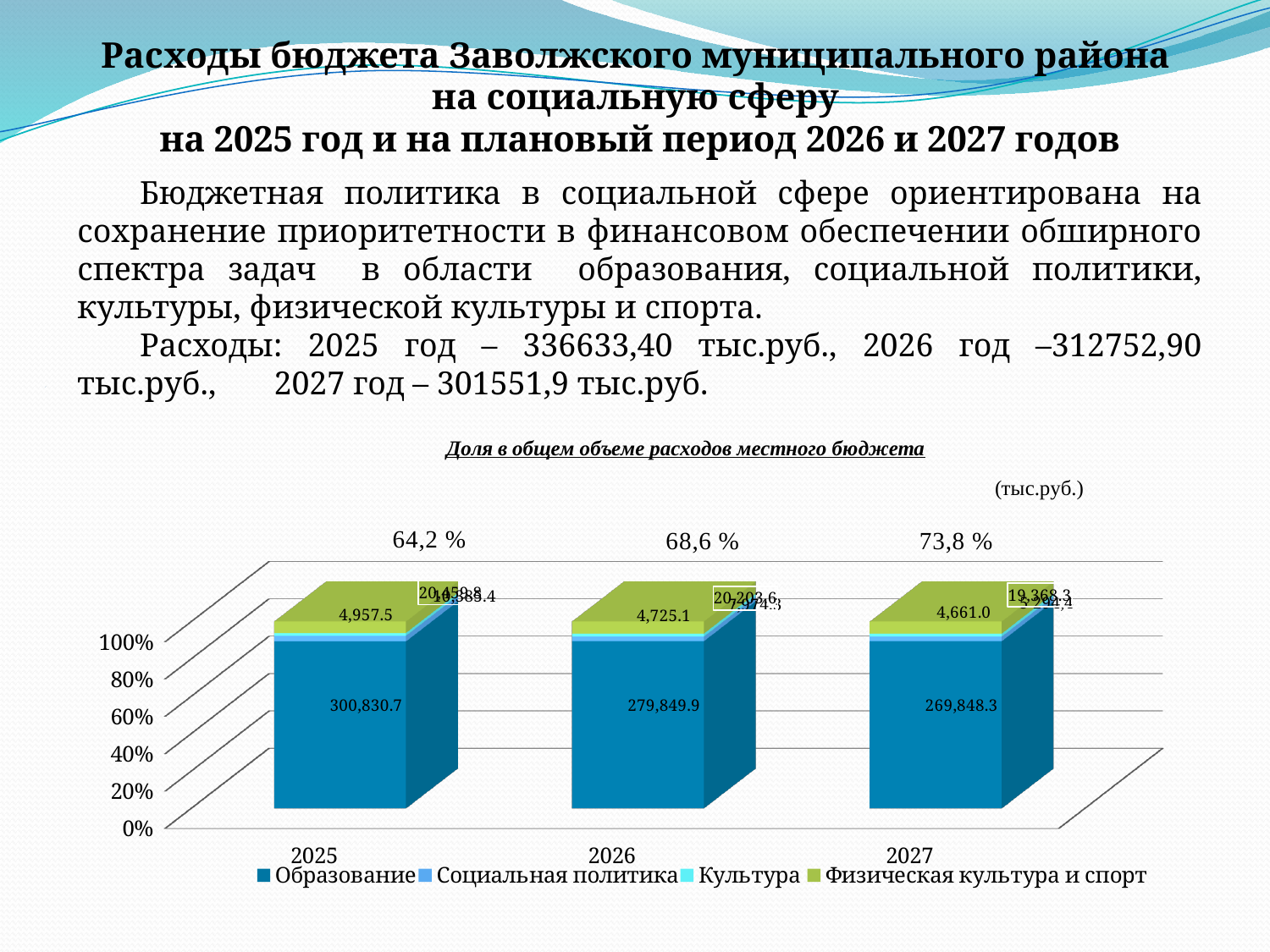
What is the value for Образование in 2025? 300,830.7 Which is larger: the Образование value for 2026 or for 2027? 2026 What is the difference between the Физическая культура и спорт values for 2025 and 2027? 1,091.5 How many years (categories) are shown on the x axis of the chart? 3 What is the difference between the Образование values for 2025 and 2026? 20,980.8 What kind of chart is shown on the slide? Stacked bar chart What is the value for Физическая культура и спорт in 2026? 20,203.6 What percentage is shown above the 2027 bar? 73,8 % Do the Образование values rise or fall from 2025 to 2027? Fall In which year is the value for Образование the highest? 2025 What is the value for Образование in 2027? 269,848.3 How many series does the chart legend list? 4